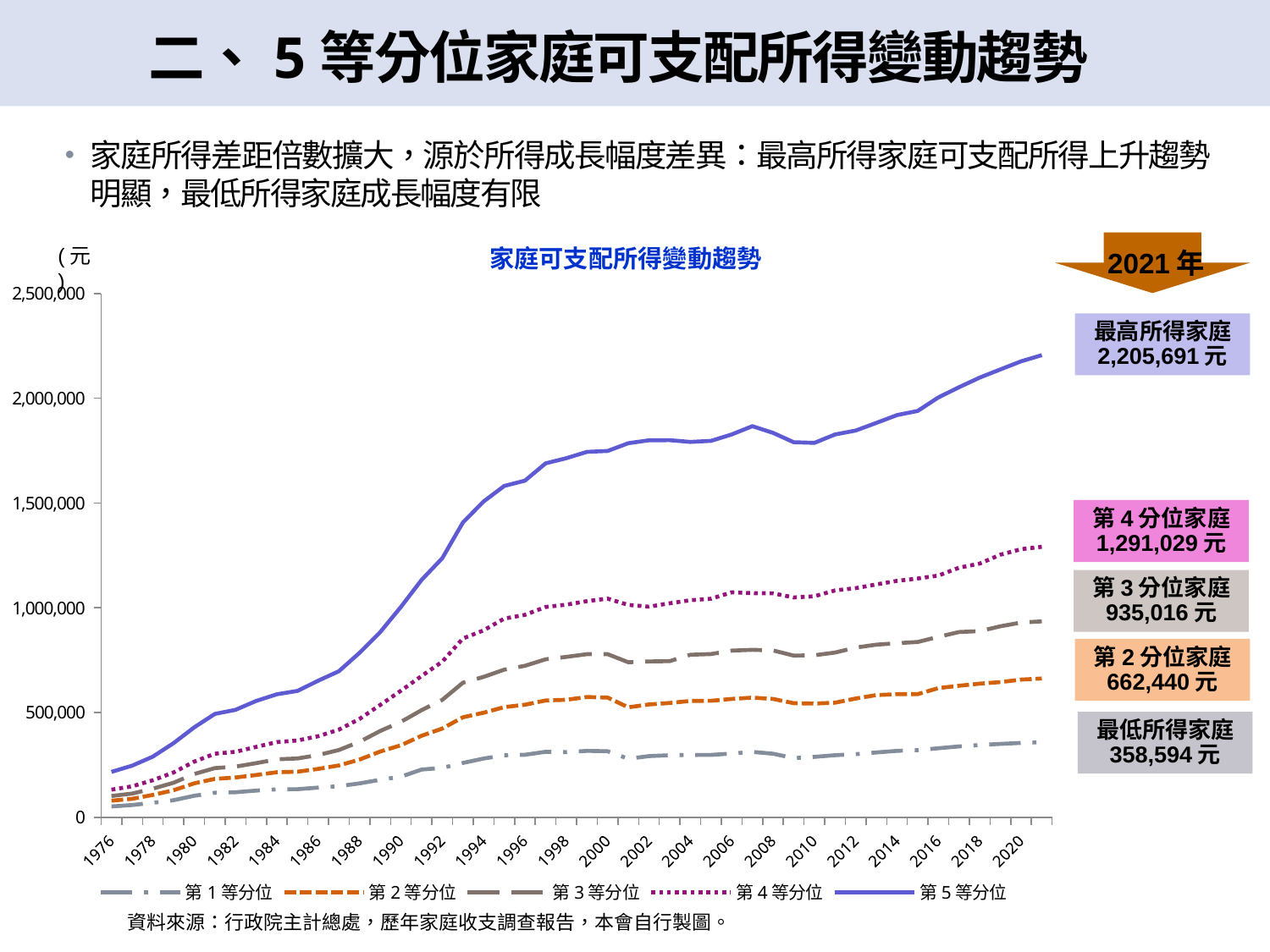
What is the 2021 value shown for 第 2 分位家庭? 662,440 元 What kind of chart is shown on the slide? line chart What is the 2021 value shown for 第 3 分位家庭? 935,016 元 How many series does the legend of the chart list? 5 What is the 2021 value shown for 第 4 分位家庭? 1,291,029 元 Is the value for 第 5 等分位 in 2000 greater or less than 1,500,000? greater Does the 第 5 等分位 line generally rise or fall from 1976 to 2021? rise Which series has the highest value in 2021? 第 5 等分位 What is the 2021 value shown for the lowest-income households (最低所得家庭)? 358,594 元 What is the title of the chart? 家庭可支配所得變動趨勢 What is the 2021 disposable income of the highest-income households (最高所得家庭) shown on the slide? 2,205,691 元 What is the difference between the 2021 values of the highest-income households and the lowest-income households? 1,847,097 元